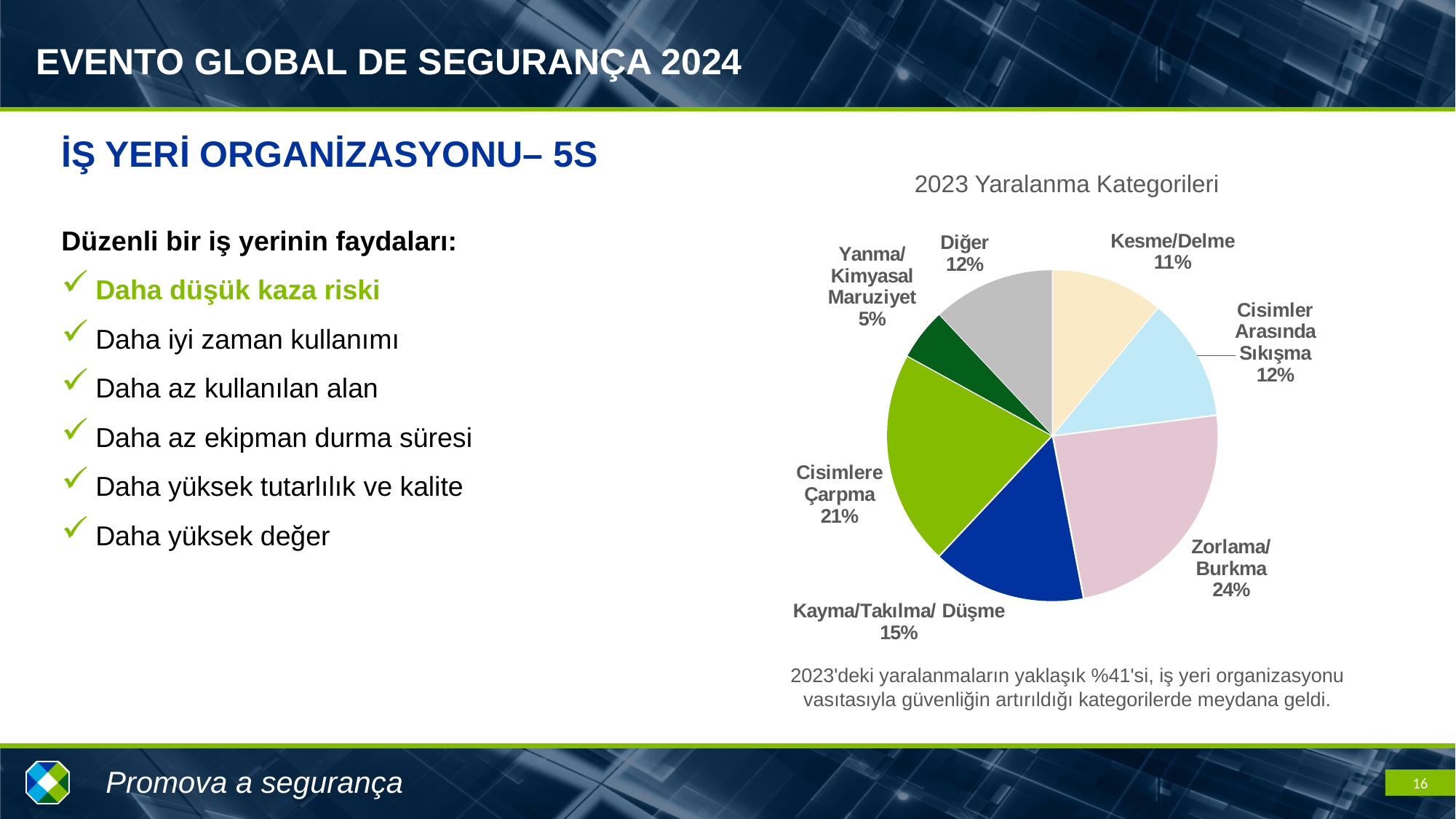
Which category has the smallest share of the pie? Yanma/Kimyasal Maruziyet What percentage of the pie is Cisimlere Çarpma? 21% What type of chart is shown on the slide? pie chart What is the title of the chart? 2023 Yaralanma Kategorileri What colour is the Kayma/Takılma/ Düşme slice? dark blue What is the difference in percentage points between Zorlama/Burkma and Kesme/Delme? 13 Which category has the largest share of the pie? Zorlama/Burkma What percentage of the pie is Yanma/Kimyasal Maruziyet? 5% Which is larger, the share for Cisimlere Çarpma or the share for Kayma/Takılma/ Düşme? Cisimlere Çarpma What percentage of the pie is Kayma/Takılma/ Düşme? 15% What percentage of the pie is Zorlama/Burkma? 24% How many categories are shown in the pie chart? 7